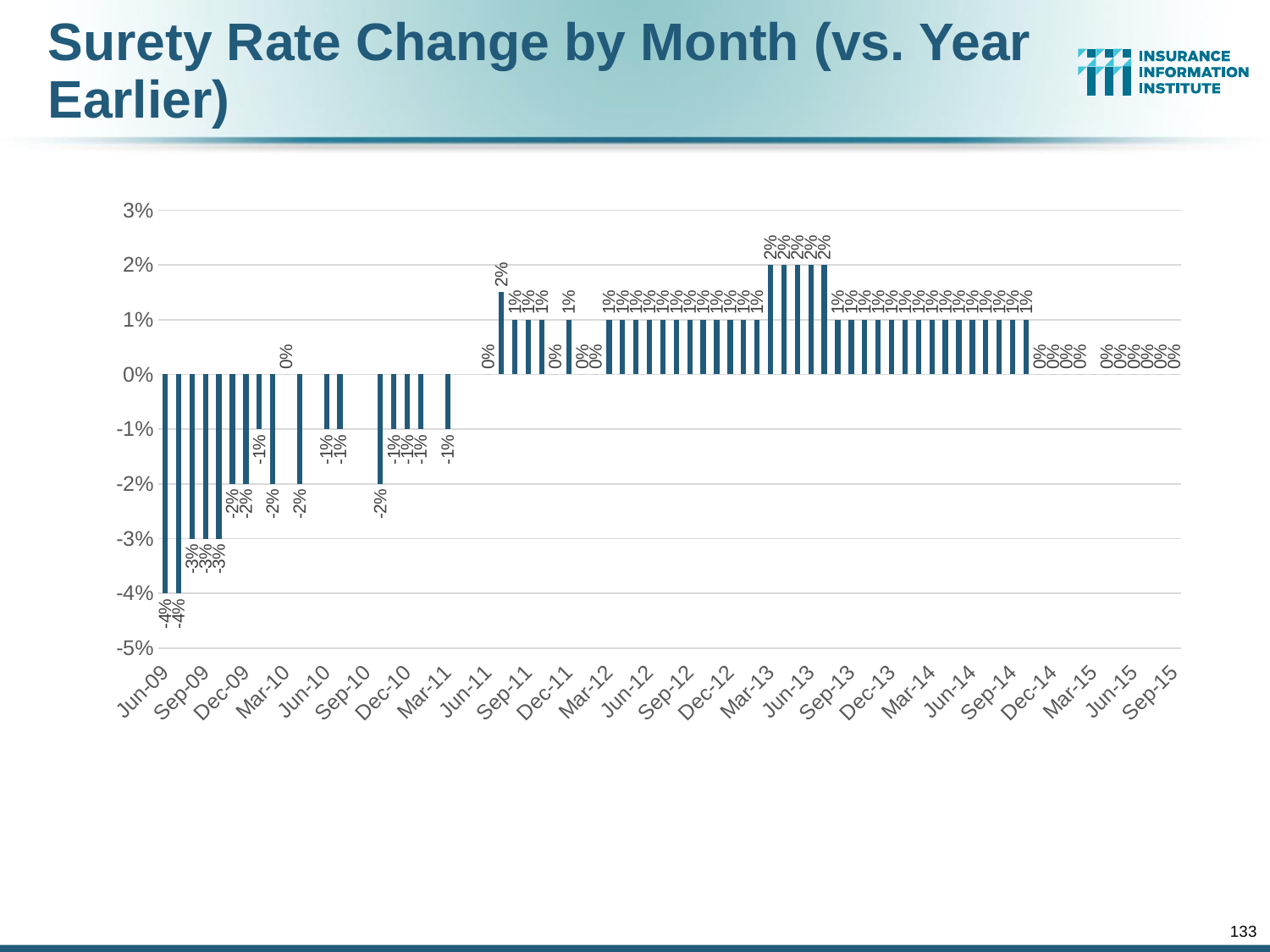
What is the surety rate change for Mar-10? 0% What is the difference in percentage points between the surety rate change for Jun-13 and Jun-09? 6 percentage points What is the title of the chart? Surety Rate Change by Month (vs. Year Earlier) Does the surety rate change generally rise or fall from Jun-09 to Jun-13? Rise What is the lowest surety rate change value shown on the chart? -4% What is the surety rate change for Jun-12? 1% Which has the larger surety rate change, Jun-09 or Jun-13? Jun-13 What is the surety rate change for Jun-09? -4% What is the surety rate change for Jun-13? 2% What is the highest surety rate change value shown on the chart? 2% What is the surety rate change for Sep-15? 0% What type of chart is shown on the slide? Bar chart